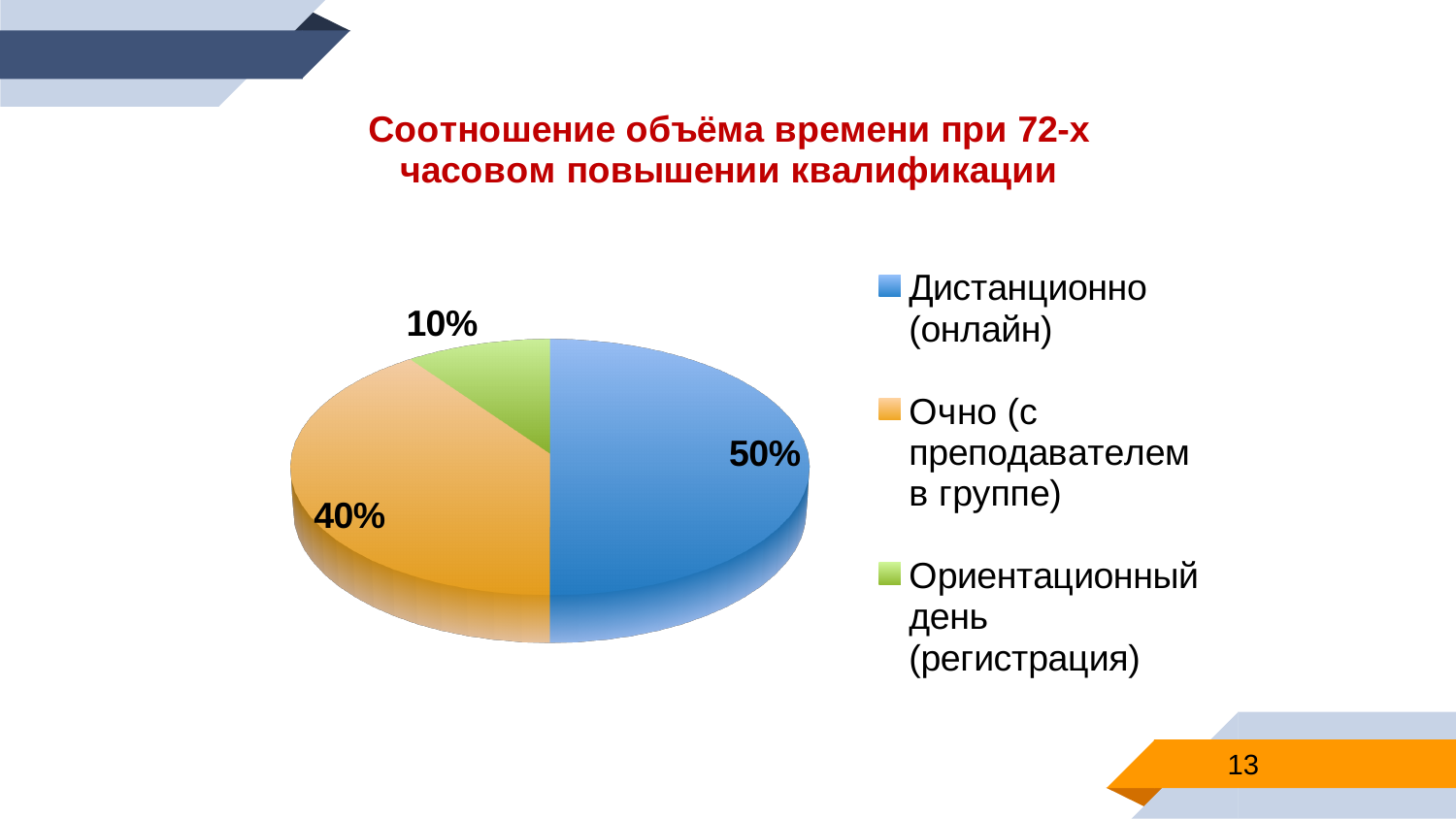
What is the difference between the shares of "Очно (с преподавателем в группе)" and "Ориентационный день (регистрация)"? 30% What kind of chart is shown on the slide? Pie chart Which is larger: the share for "Очно (с преподавателем в группе)" or for "Ориентационный день (регистрация)"? Очно (с преподавателем в группе) What colour is the slice for "Ориентационный день (регистрация)"? Green How many categories does the pie chart have? 3 What is the difference between the shares of "Дистанционно (онлайн)" and "Очно (с преподавателем в группе)"? 10% What share of the pie does "Дистанционно (онлайн)" take? 50% What share of the pie does "Ориентационный день (регистрация)" take? 10% Which category has the largest slice of the pie? Дистанционно (онлайн) Which category has the smallest slice of the pie? Ориентационный день (регистрация) What is the title of the chart? Соотношение объёма времени при 72-х часовом повышении квалификации What share of the pie does "Очно (с преподавателем в группе)" take? 40%